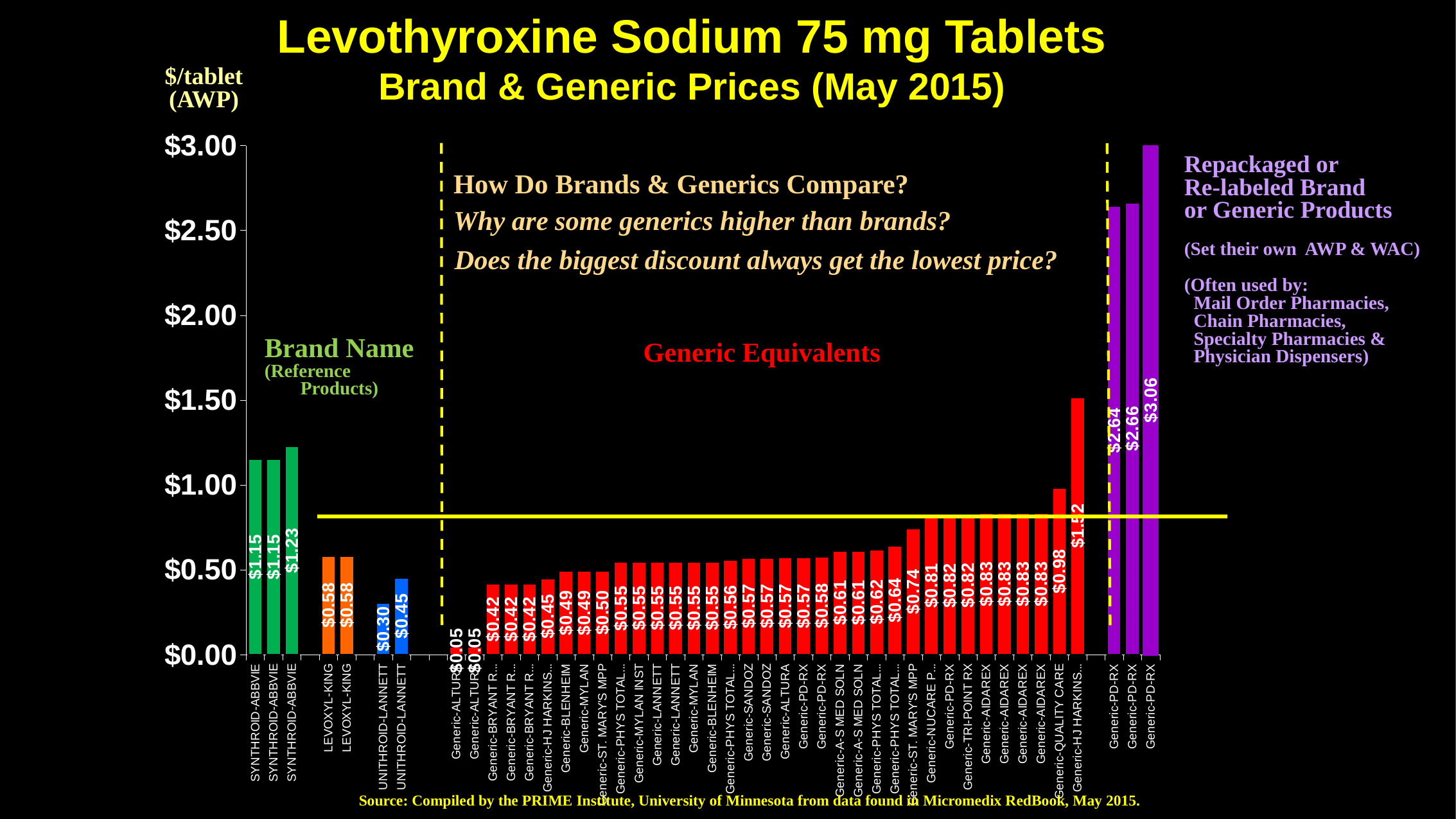
Which product has the lowest price per tablet on the chart? Generic-ALTURA ($0.05) How many Generic-AIDAREX bars are shown on the chart? 4 Which product has the highest price per tablet on the chart? Generic-PD-RX ($3.06) Which is larger: the Generic-QUALITY CARE price or the lowest SYNTHROID-ABBVIE price? SYNTHROID-ABBVIE ($1.15) What is the price per tablet of the Generic-QUALITY CARE bar? $0.98 What is the difference between the highest SYNTHROID-ABBVIE price ($1.23) and the LEVOXYL-KING price ($0.58)? $0.65 What is the price per tablet of the UNITHROID-LANNETT bar with the lowest value? $0.30 Is the value for Generic-QUALITY CARE greater or less than $1.00? less What is the label on the y axis of the chart? $/tablet (AWP) What kind of chart is shown on the slide? bar chart What is the price per tablet of the highest Generic-PD-RX bar? $3.06 What is the difference between the highest Generic-PD-RX price ($3.06) and the Generic-HJ HARKINS price of $1.52? $1.54